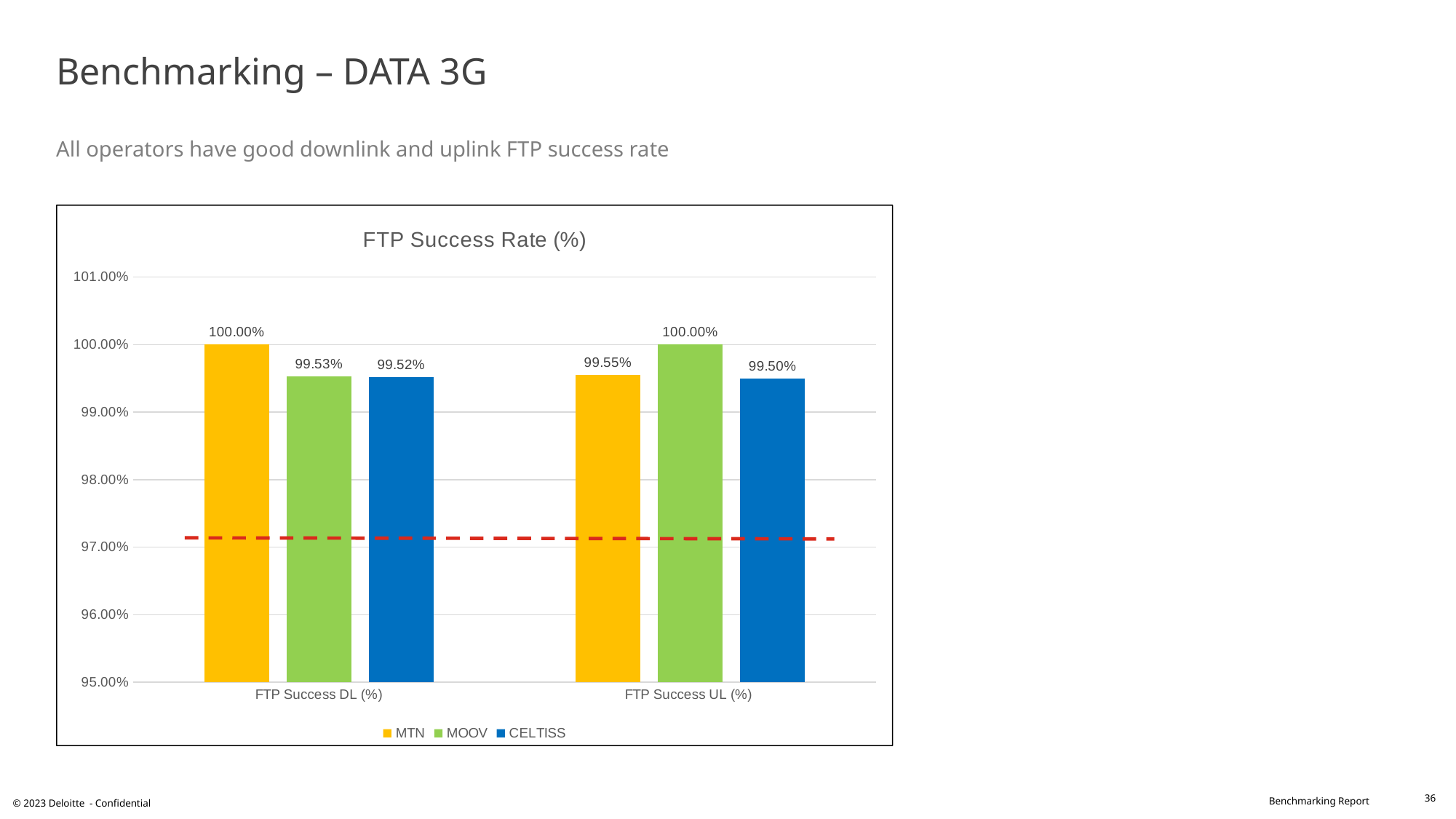
Is MTN's FTP Success DL (%) value larger or smaller than its FTP Success UL (%) value? larger What type of chart is shown on the slide? bar chart Which operator has the highest FTP Success UL (%)? MOOV What is the difference between MTN's and MOOV's FTP Success DL (%) values? 0.47% What is the FTP Success DL (%) value for MOOV? 99.53% Which operator has the highest FTP Success DL (%)? MTN Is the FTP Success UL (%) value for CELTISS greater or less than 99.00%? greater How many series does the chart legend list? 3 What is the FTP Success DL (%) value for MTN? 100.00% What is the FTP Success UL (%) value for CELTISS? 99.50% How many categories are shown on the x axis of the chart? 2 What is the FTP Success UL (%) value for MTN? 99.55%